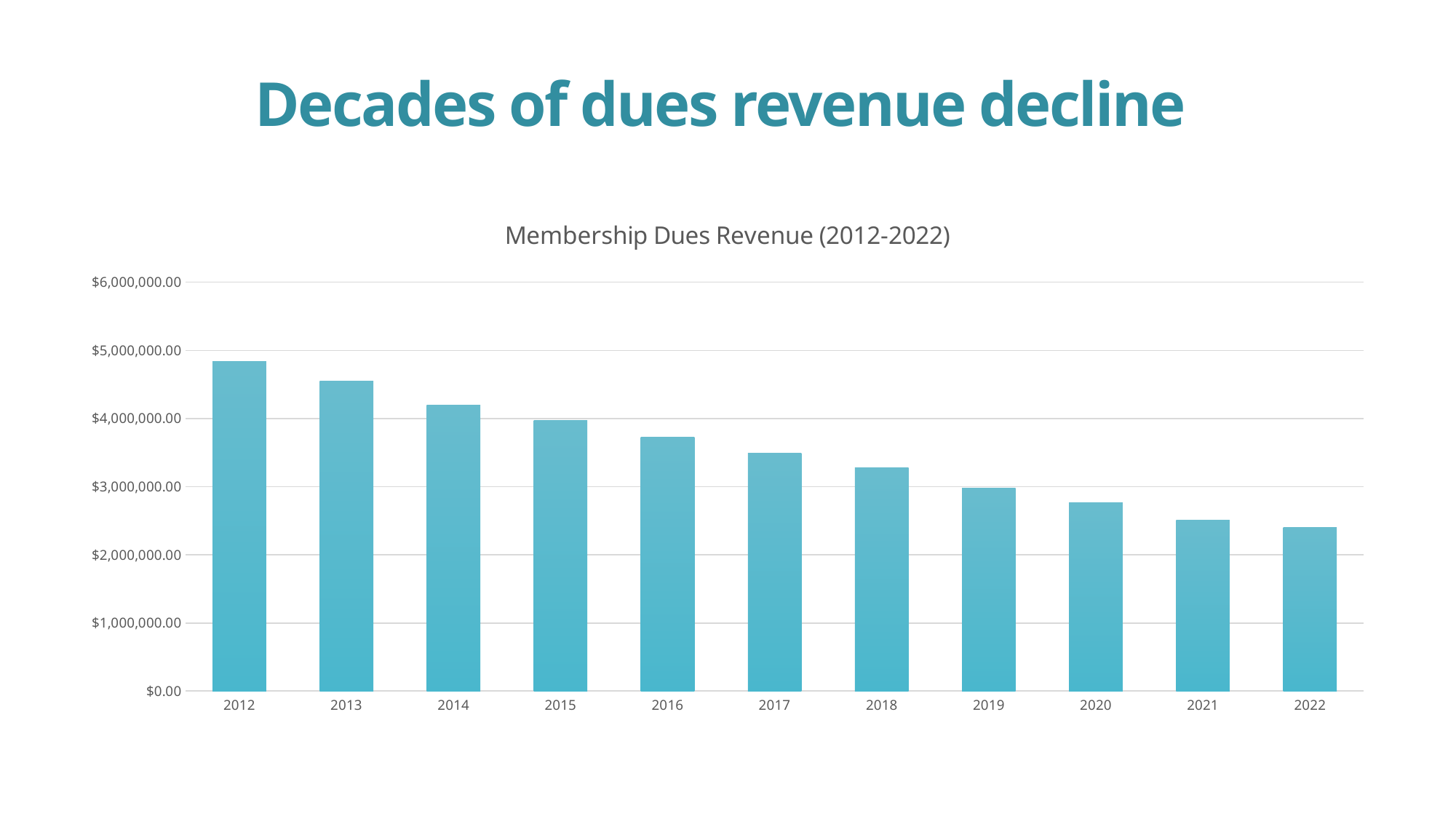
Is the value for 2016 greater or less than $3,000,000.00? greater Is the value for 2018 greater or less than $4,000,000.00? less What is the title of the chart? Membership Dues Revenue (2012-2022) Is the value for 2012 greater or less than $4,000,000.00? greater How many years are plotted in the chart? 11 Which year has the highest membership dues revenue? 2012 What kind of chart is shown on the slide? Bar chart Which year has the lowest membership dues revenue? 2022 Which year has the larger membership dues revenue, 2014 or 2018? 2014 Do the membership dues revenue values rise or fall from 2012 to 2022? Fall Which year has the larger membership dues revenue, 2012 or 2022? 2012